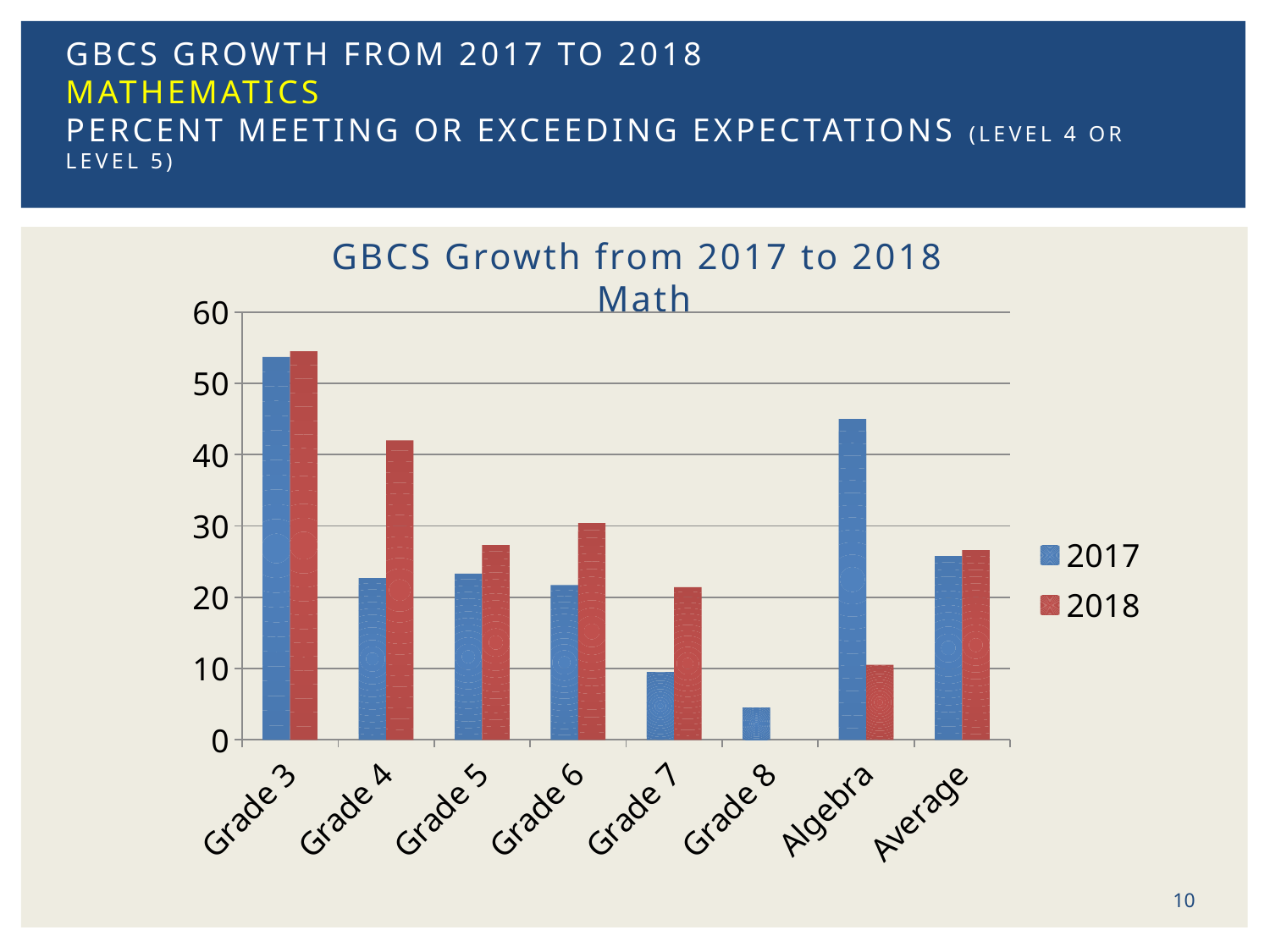
For Grade 7, which is larger: the 2017 value or the 2018 value? 2018 Is the 2017 value for Grade 8 greater or less than 10? less Is the 2018 value for Grade 4 greater or less than 40? greater What kind of chart is shown on the slide? bar chart Which category has the lowest value for 2017? Grade 8 Is the 2017 value for Algebra greater or less than 40? greater Which category has the highest value for 2017? Grade 3 Which category has the highest value for 2018? Grade 3 What colour are the bars for the 2018 series? red For Algebra, which is larger: the 2017 value or the 2018 value? 2017 How many series does the legend list? 2 How many categories are shown on the x axis? 8